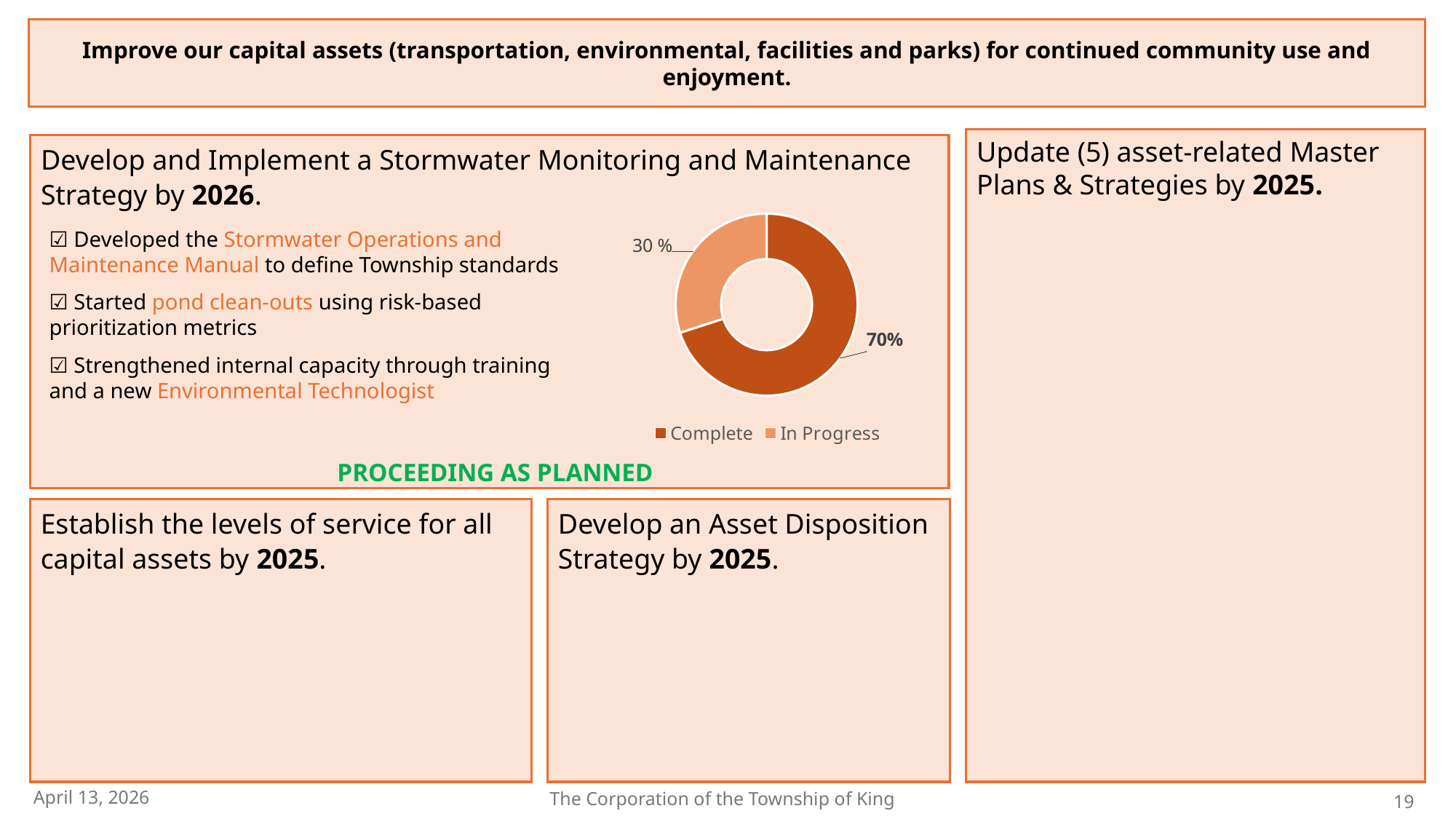
What is the difference in percentage points between the Complete and In Progress slices? 40 How many slices does the donut chart have? 2 What kind of chart is shown on the slide? Donut chart What are the two legend entries of the donut chart? Complete and In Progress Which slice of the donut chart is the smallest? In Progress Which legend entry is shown in the darker orange colour? Complete Is the Complete slice larger or smaller than the In Progress slice? Larger What share of the donut chart does the In Progress slice represent? 30 % How many entries does the chart legend list? 2 Which slice of the donut chart is the largest? Complete What percentage of the donut chart is labelled Complete? 70% What percentage of the donut chart is labelled In Progress? 30 %